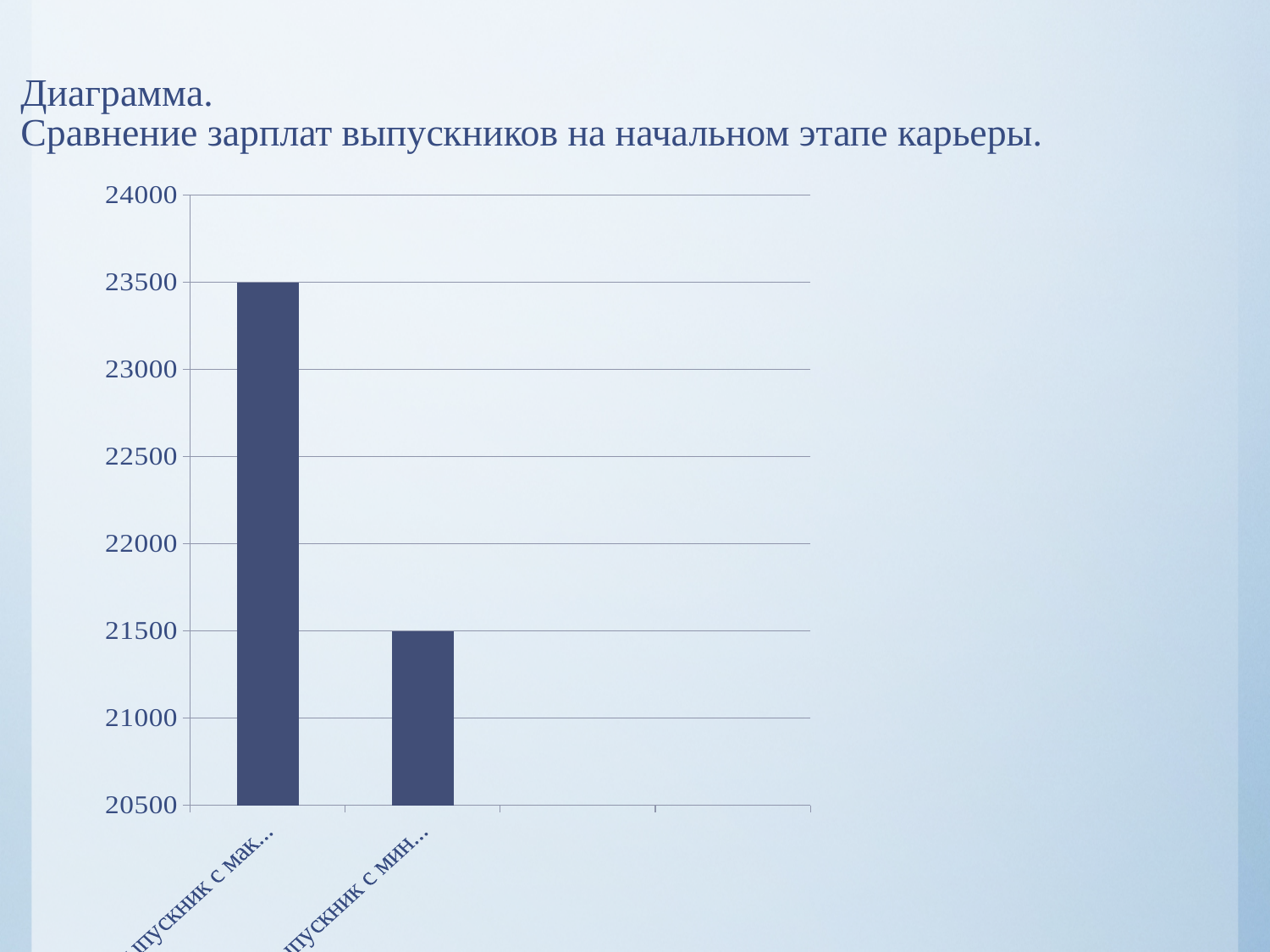
What is the highest value shown on the vertical axis of the chart? 24000 Do the bar values rise or fall from left to right along the x axis? fall What is the difference between the values of the left bar and the right bar? 2000 What is the value of the right (second) bar in the chart? 21500 Which bar has the lowest value in the chart? the right (second) bar Is the value of the right bar greater or less than 22000? less What kind of chart is shown on the slide? bar chart Is the value of the left bar greater or less than 23000? greater Which bar is taller, the left one or the right one? the left one How many bars are plotted in the chart? 2 What is the lowest value shown on the vertical axis of the chart? 20500 What is the value of the left (first) bar in the chart? 23500